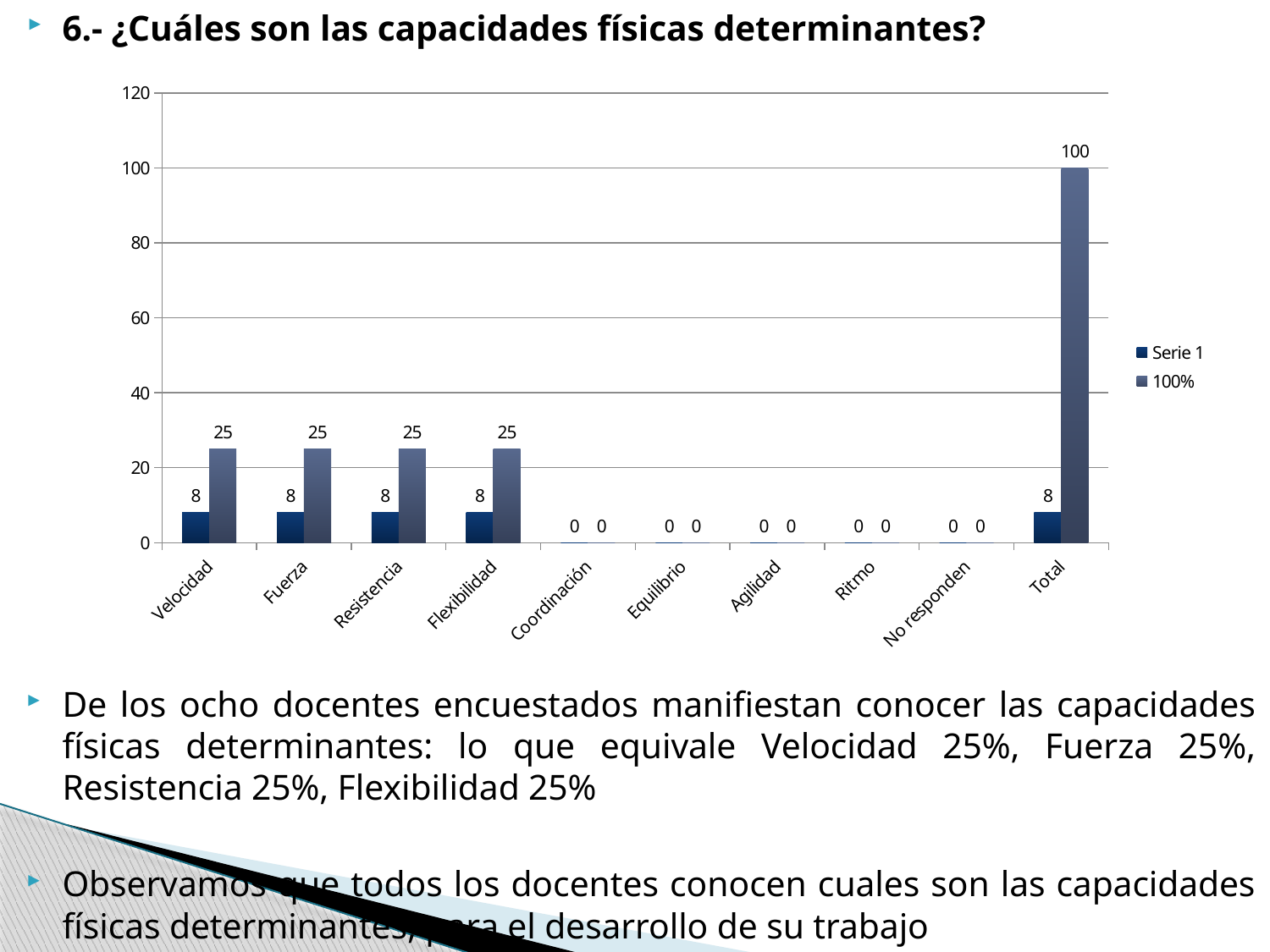
What is the value of Serie 1 for Coordinación? 0 Which category has the highest value in the 100% series? Total What are the two entries in the chart legend? Serie 1 and 100% What kind of chart is shown on the slide? bar chart Is the 100% series value for Total greater or less than 80? greater What is the value of the 100% series for Total? 100 What is the value of Serie 1 for Total? 8 What is the difference between the 100% series value for Total and the 100% series value for Fuerza? 75 How many categories are shown on the x axis? 10 What is the value of the 100% series for Velocidad? 25 How many series does the legend list? 2 Which is larger: the 100% series value for Resistencia or the Serie 1 value for Resistencia? 100% series value for Resistencia